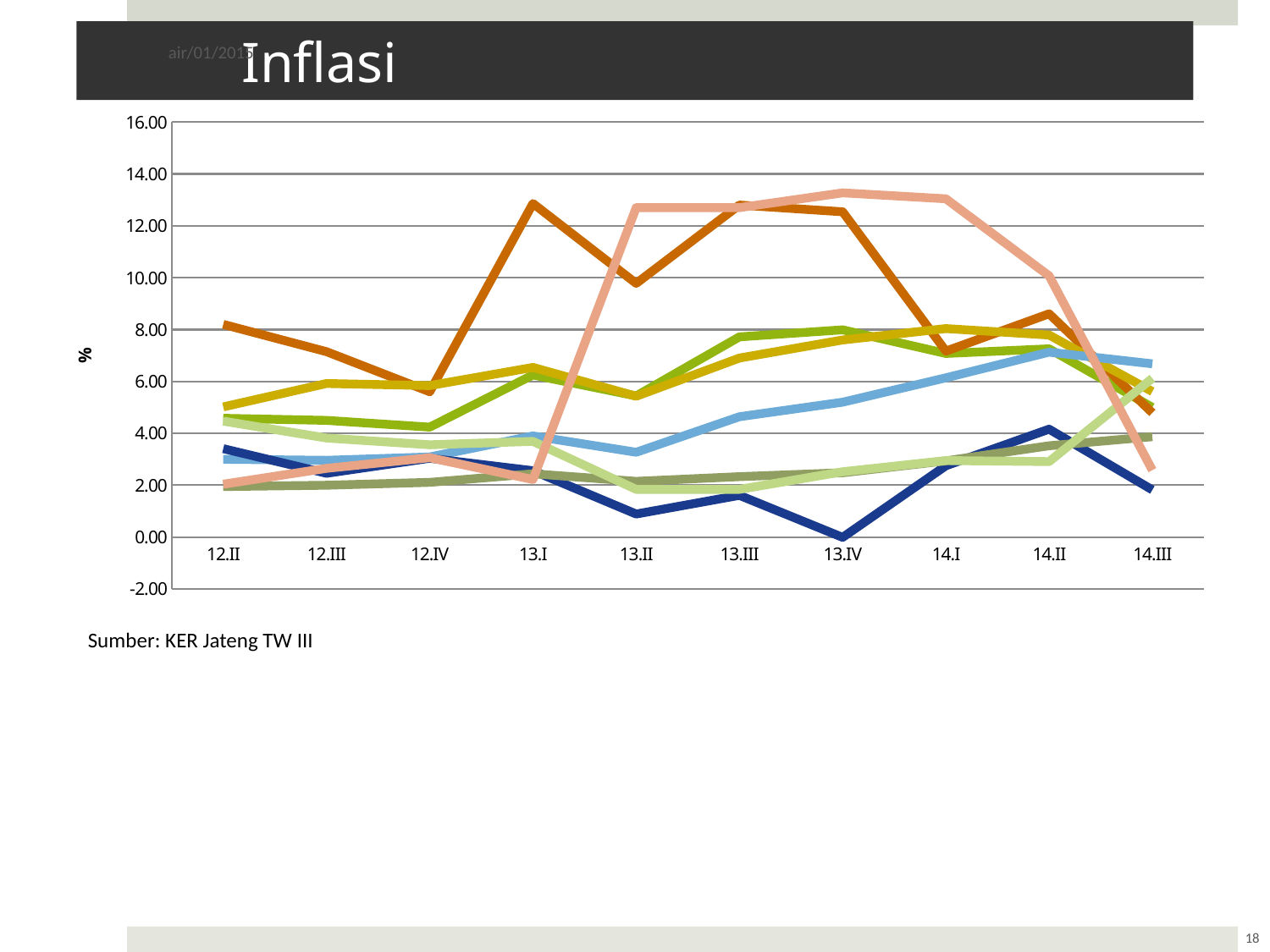
At which category does the dark blue line reach its lowest value? 13.IV How many categories are shown on the x axis of the chart? 10 Is the value of the light salmon line at 13.IV greater or less than 12.00? greater Does the light salmon line rise or fall from 14.I to 14.III? fall What is the title of the chart on the slide? Inflasi What kind of chart is shown on the slide? line chart Is the value of the dark blue line at 13.IV greater or less than 2.00? less Is the value of the dark orange line at 13.I greater or less than 10.00? greater At 13.I, which line has the larger value: the dark orange line or the light salmon line? dark orange line What is the label on the vertical axis of the chart? % Does the light blue line rise or fall from 13.II to 14.II? rise